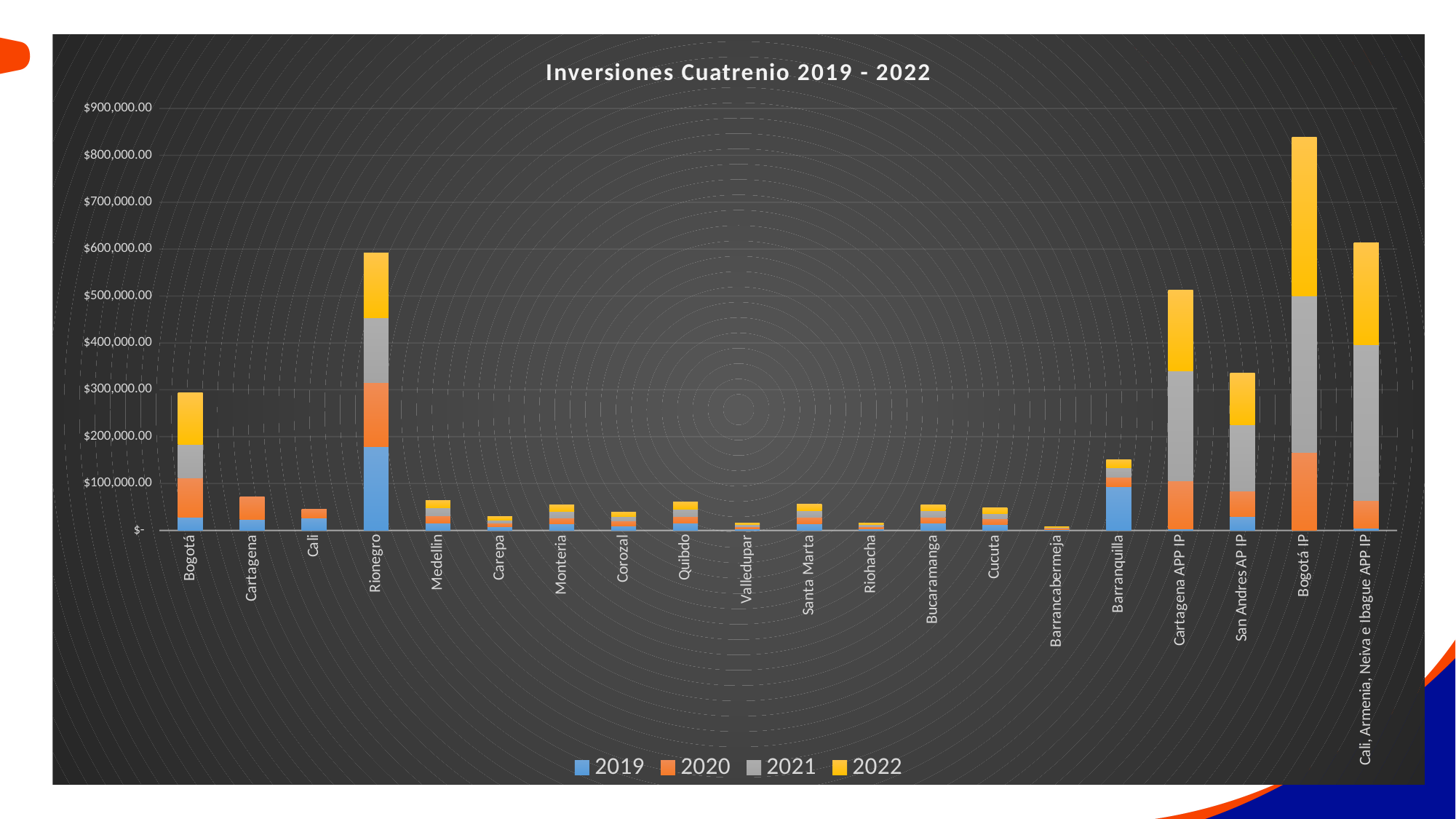
Is the total value for Bogotá IP greater or less than $800,000.00? greater Which has the larger total bar, Rionegro or Cartagena APP IP? Rionegro What type of chart is shown on the slide? Stacked bar chart Which category has the highest total bar? Bogotá IP How many categories are shown on the x axis? 20 Is the total value for Barranquilla greater or less than $100,000.00? greater Which category has the lowest total bar? Barrancabermeja Is the total value for Valledupar greater or less than $100,000.00? less What is the title of the chart? Inversiones Cuatrenio 2019 - 2022 How many series does the legend list? 4 Which years are listed in the legend? 2019, 2020, 2021, 2022